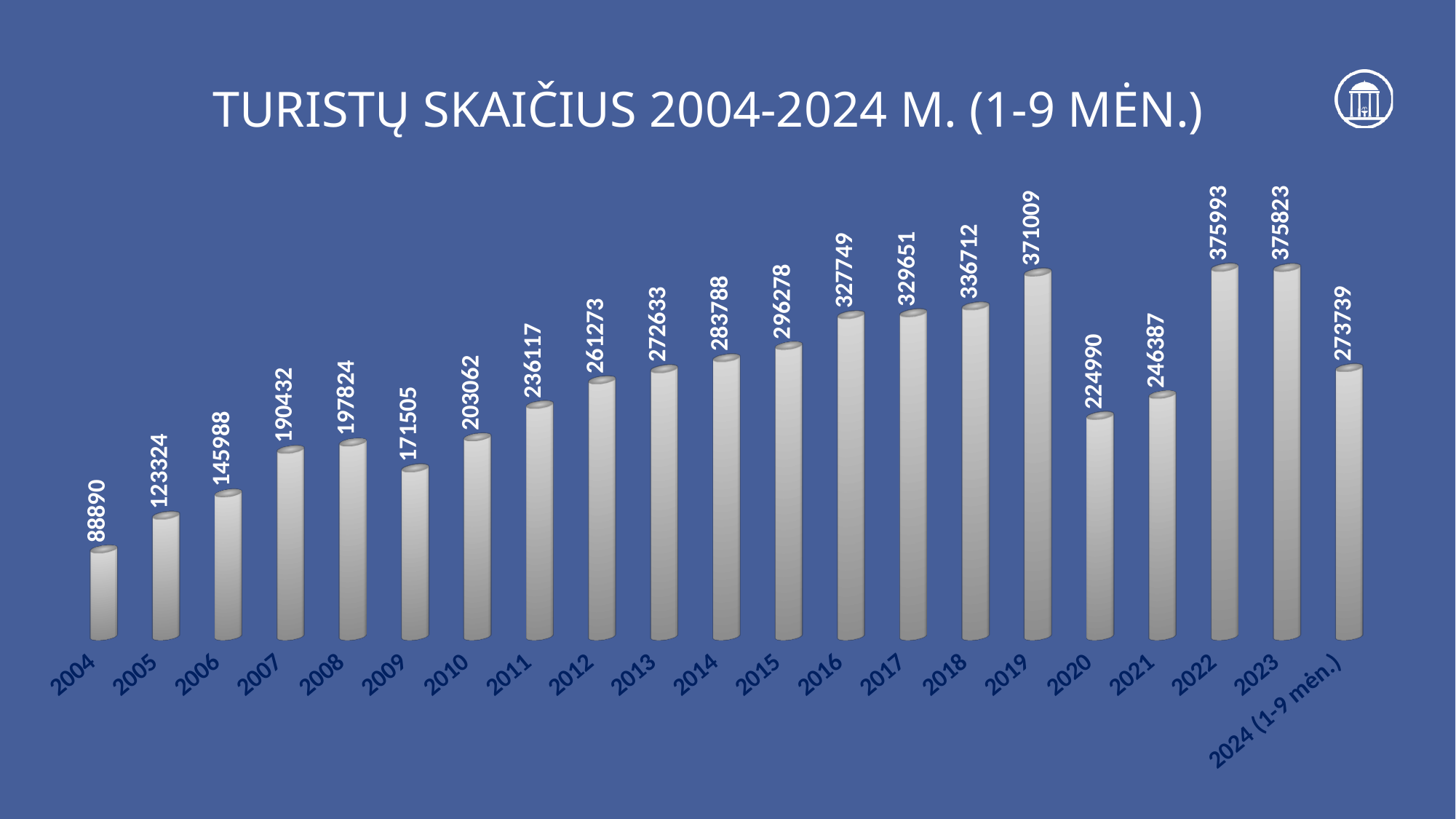
How many bars are shown in the chart? 21 Which is larger, the value for 2008 or the value for 2009? 2008 What is the value for 2019? 371009 What is the difference between the values for 2019 and 2020? 146019 What is the value for 2024 (1-9 mėn.)? 273739 What is the value for 2004? 88890 What kind of chart is shown on the slide? bar chart Which year has the lowest value? 2004 Which year has the highest value? 2022 What is the difference between the values for 2005 and 2004? 34434 Do the values rise or fall from 2004 to 2008? rise What is the value for 2020? 224990